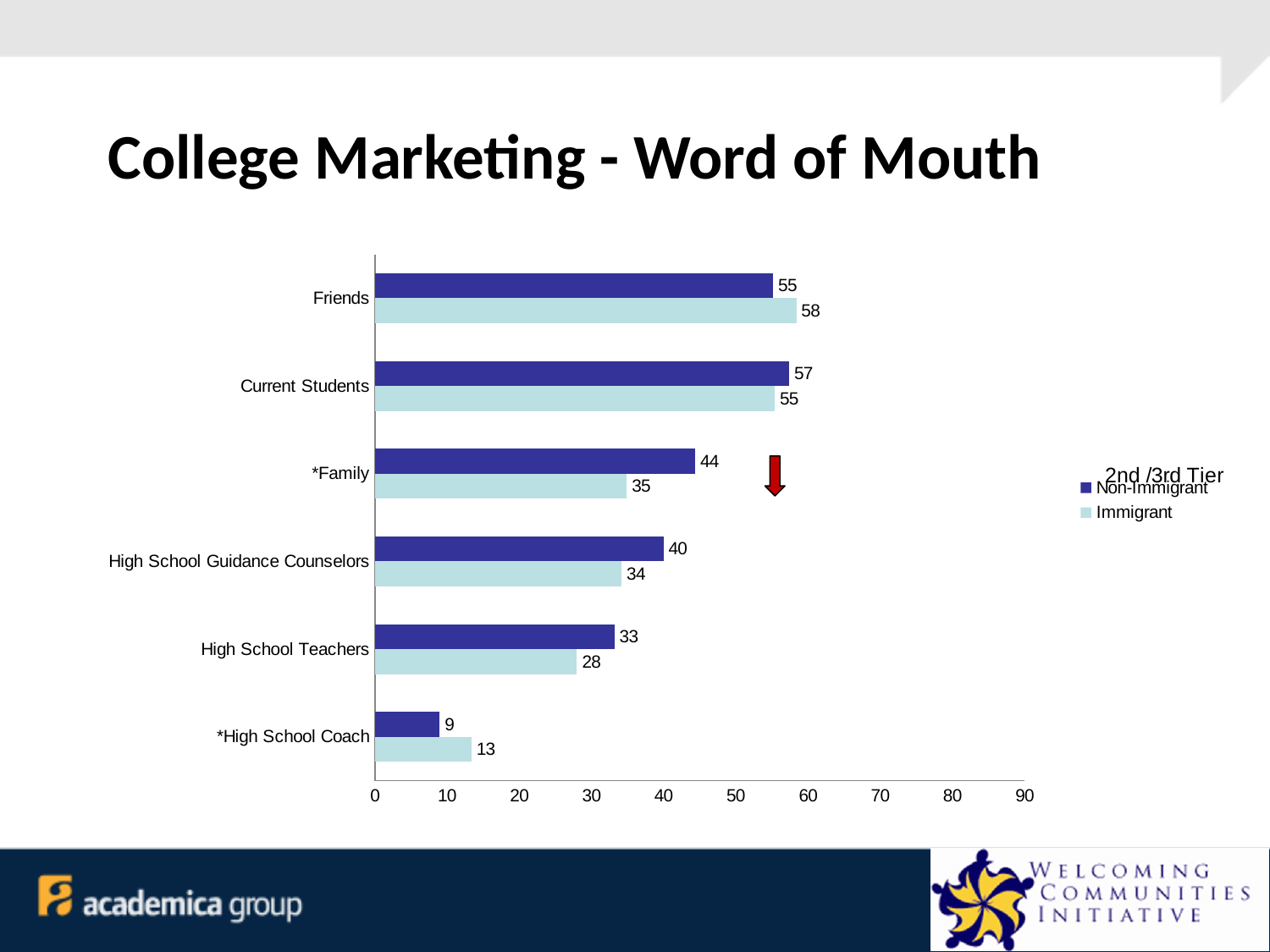
What kind of chart is shown on the slide? Bar chart What is the difference between the Non-Immigrant and Immigrant values for *Family? 9 What is the Non-Immigrant value for Friends? 55 Which is larger for *High School Coach, the Non-Immigrant value or the Immigrant value? Immigrant Is the Non-Immigrant value for High School Guidance Counselors greater or less than 30? greater Which category has the highest Immigrant value? Friends What is the title of the slide? College Marketing - Word of Mouth How many series does the legend list? 2 Which category has the lowest Non-Immigrant value? *High School Coach What is the Immigrant value for *Family? 35 What is the Immigrant value for High School Teachers? 28 How many categories are shown on the chart? 6